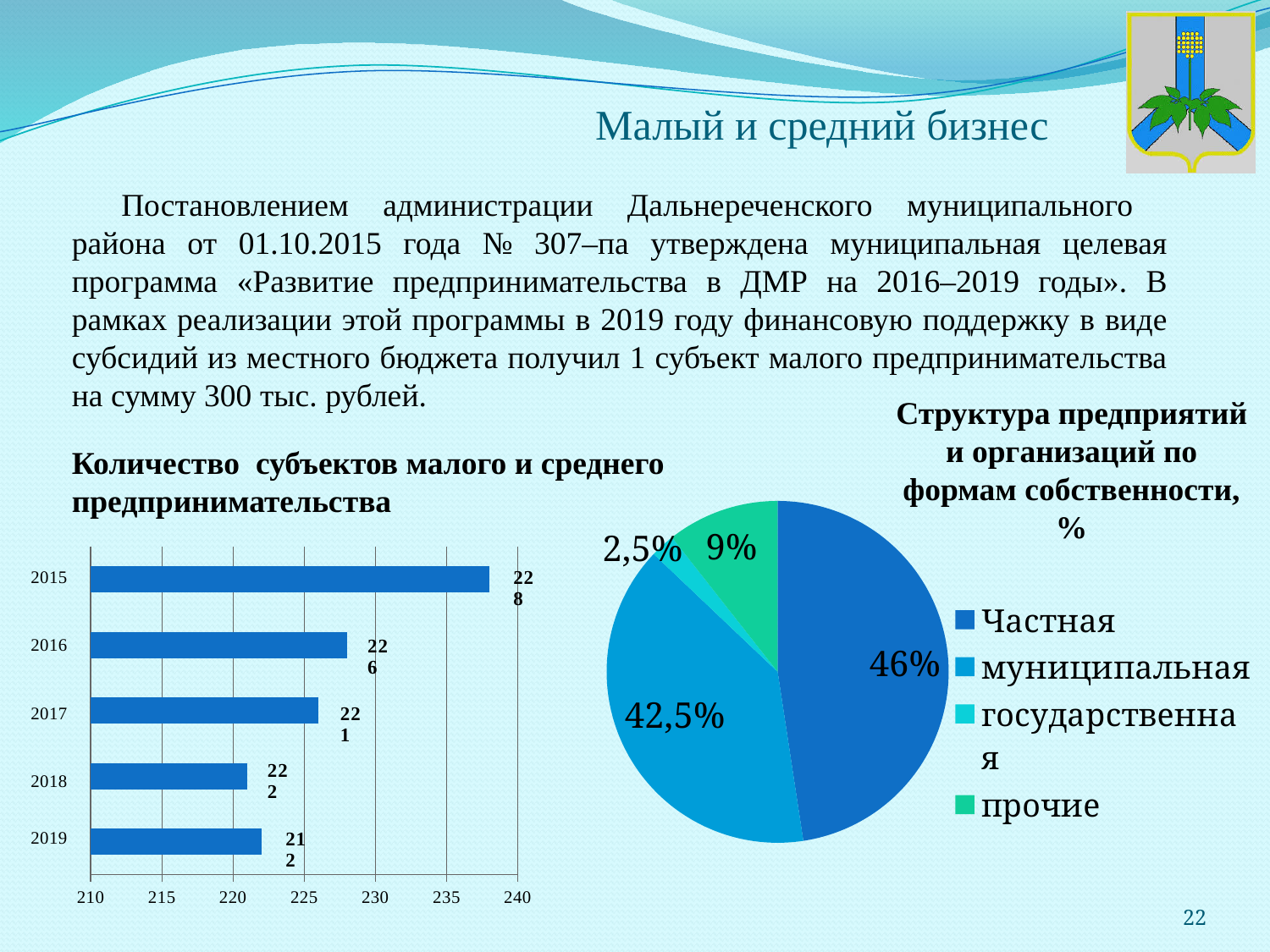
What kind of chart is the chart titled «Количество субъектов малого и среднего предпринимательства»? bar chart What kind of chart is the chart titled «Структура предприятий и организаций по формам собственности, %»? pie chart In the chart «Количество субъектов малого и среднего предпринимательства», which year has the highest value? 2015 In the pie chart «Структура предприятий и организаций по формам собственности, %», which category has the smallest share? государственная How many entries does the legend of the pie chart «Структура предприятий и организаций по формам собственности, %» list? 4 In the pie chart «Структура предприятий и организаций по формам собственности, %», what is the share of «муниципальная»? 42,5% In the chart «Количество субъектов малого и среднего предпринимательства», what is the difference between the values for 2015 and 2019? 16 In the pie chart «Структура предприятий и организаций по формам собственности, %», what is the share of «Частная»? 46% How many years are shown in the chart «Количество субъектов малого и среднего предпринимательства»? 5